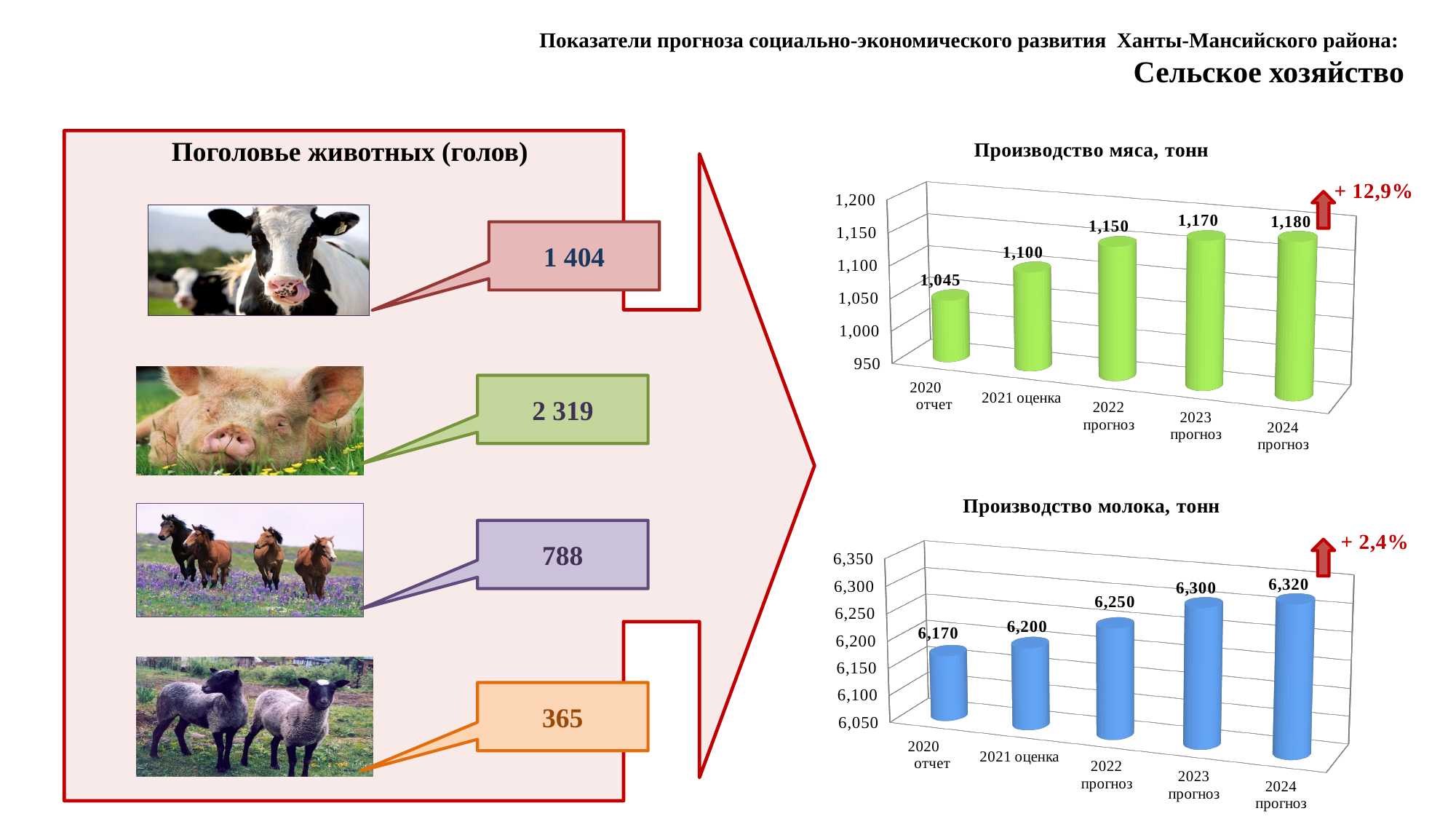
In the chart 'Производство молока, тонн', which is larger: the value for 2022 прогноз or the value for 2021 оценка? 2022 прогноз In the chart 'Производство мяса, тонн', what is the difference between the values for 2024 прогноз and 2020 отчет? 135 In the chart 'Производство мяса, тонн', what is the value for 2020 отчет? 1,045 In the chart 'Производство мяса, тонн', which category has the lowest value? 2020 отчет In the chart 'Производство молока, тонн', what is the value for 2022 прогноз? 6,250 In the chart 'Производство мяса, тонн', do the values rise or fall from 2020 отчет to 2024 прогноз? rise What type of chart is 'Производство молока, тонн'? bar chart In the chart 'Производство мяса, тонн', what is the value for 2024 прогноз? 1,180 In the chart 'Производство мяса, тонн', how many bars are plotted? 5 In the chart 'Производство молока, тонн', what is the difference between the values for 2023 прогноз and 2020 отчет? 130 In the chart 'Производство молока, тонн', what is the value for 2021 оценка? 6,200 In the chart 'Производство молока, тонн', which category has the highest value? 2024 прогноз